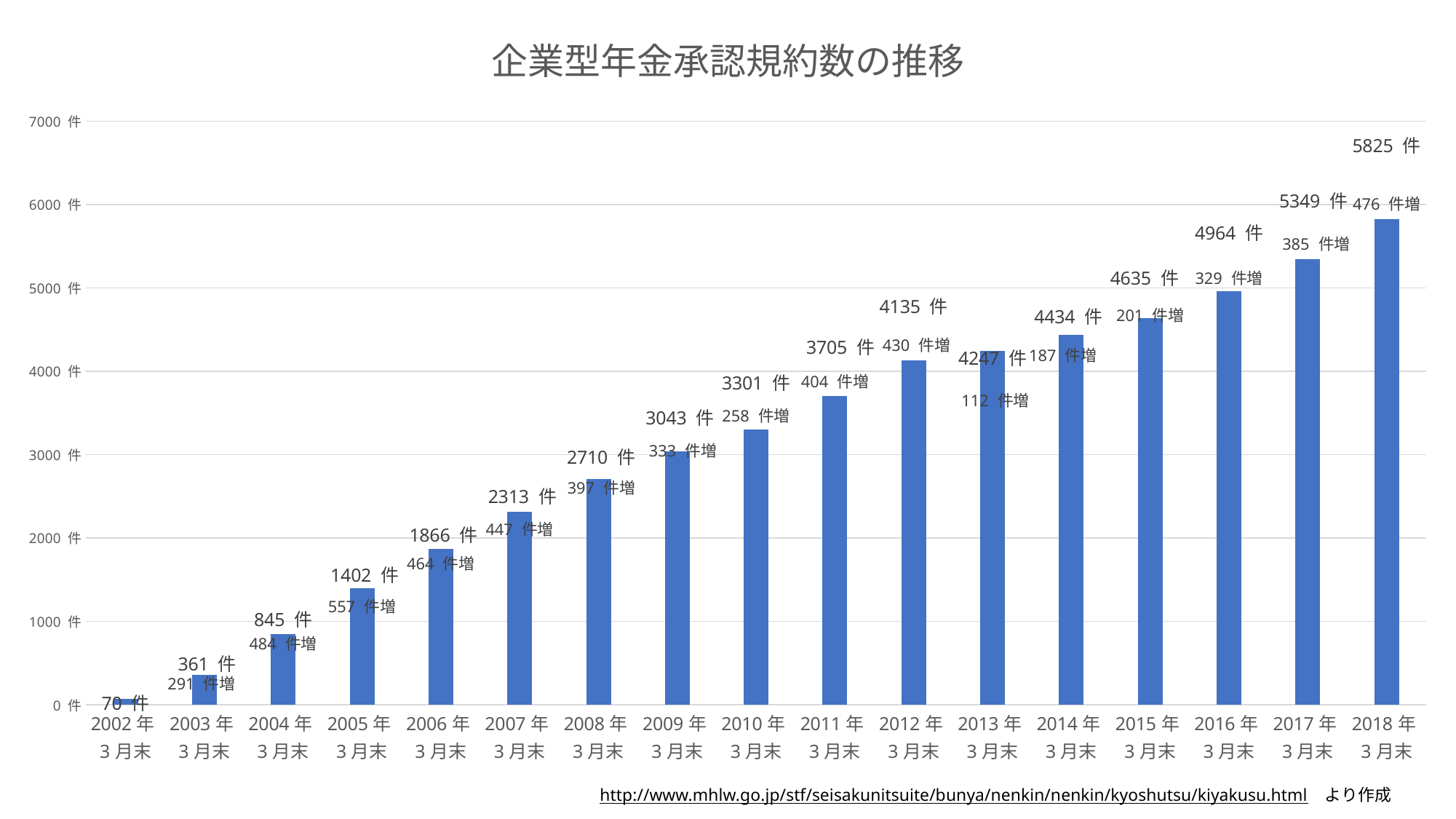
Which year has the lowest value? 2002年3月末 What is the value for 2018年3月末? 5825 件 What is the difference between the values for 2018年3月末 and 2017年3月末? 476 件 What is the value for 2010年3月末? 3301 件 Do the values rise or fall from 2002 to 2018? rise Which is larger, the value for 2009年3月末 or 2011年3月末? 2011年3月末 How many years (bars) are shown in the chart? 17 Is the value for 2016年3月末 greater or less than 5000? less What kind of chart is this? bar chart Which year has the highest value? 2018年3月末 What is the difference between the values for 2013年3月末 and 2012年3月末? 112 件 What is the value for 2002年3月末? 70 件